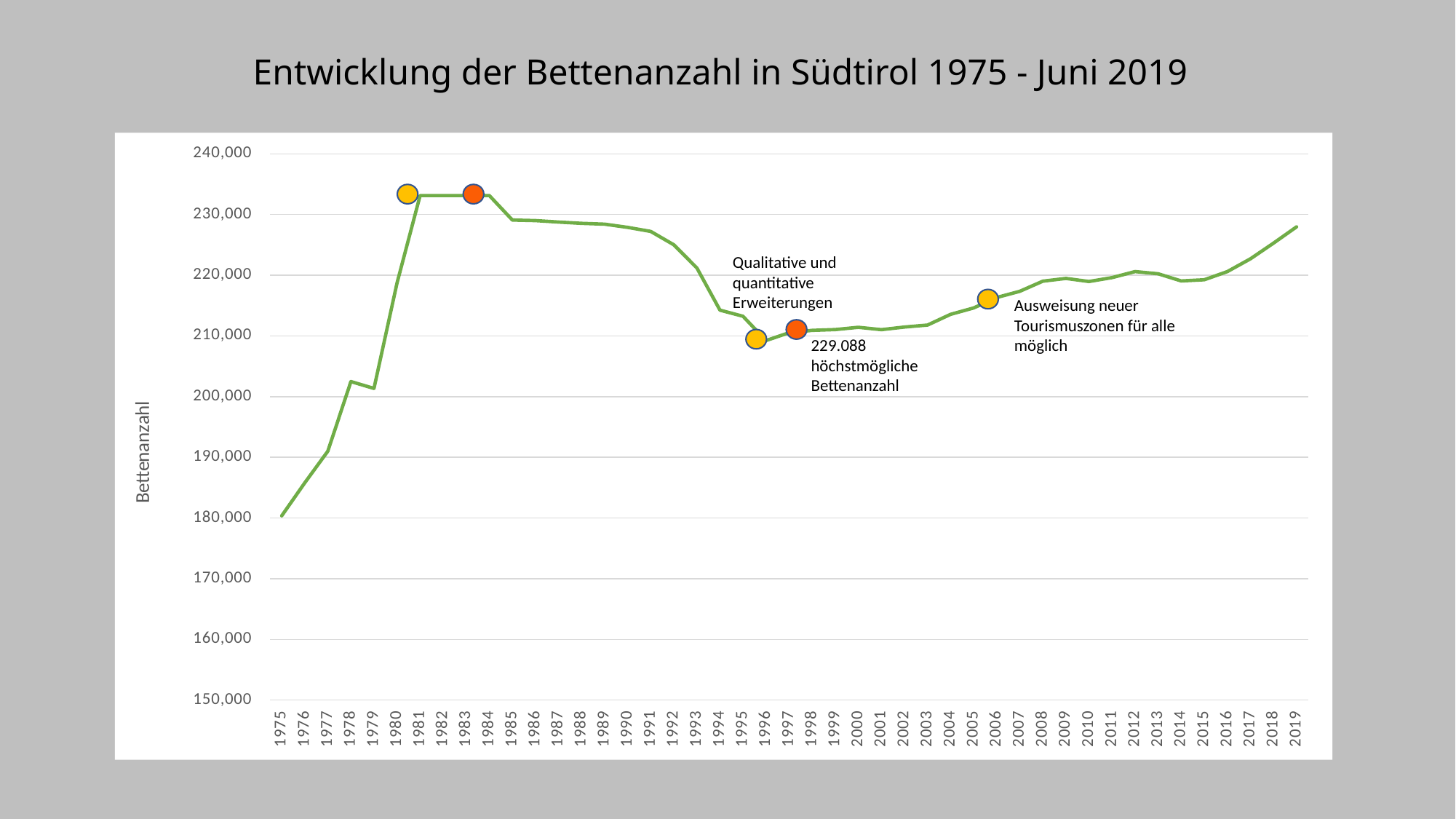
Is the value for 2019 greater or less than 230,000? less Is the value for 1994 greater or less than 210,000? greater How many years are shown on the x axis? 45 Which year has the larger value, 1981 or 2019? 1981 What kind of chart is shown on the slide? line chart Is the value for 1981 greater or less than 230,000? greater Which year has the lowest number of beds? 1975 What is the title of the chart? Entwicklung der Bettenanzahl in Südtirol 1975 - Juni 2019 Do the values rise or fall between 1984 and 1996? fall What is the label of the vertical axis? Bettenanzahl Do the values rise or fall between 1975 and 1981? rise